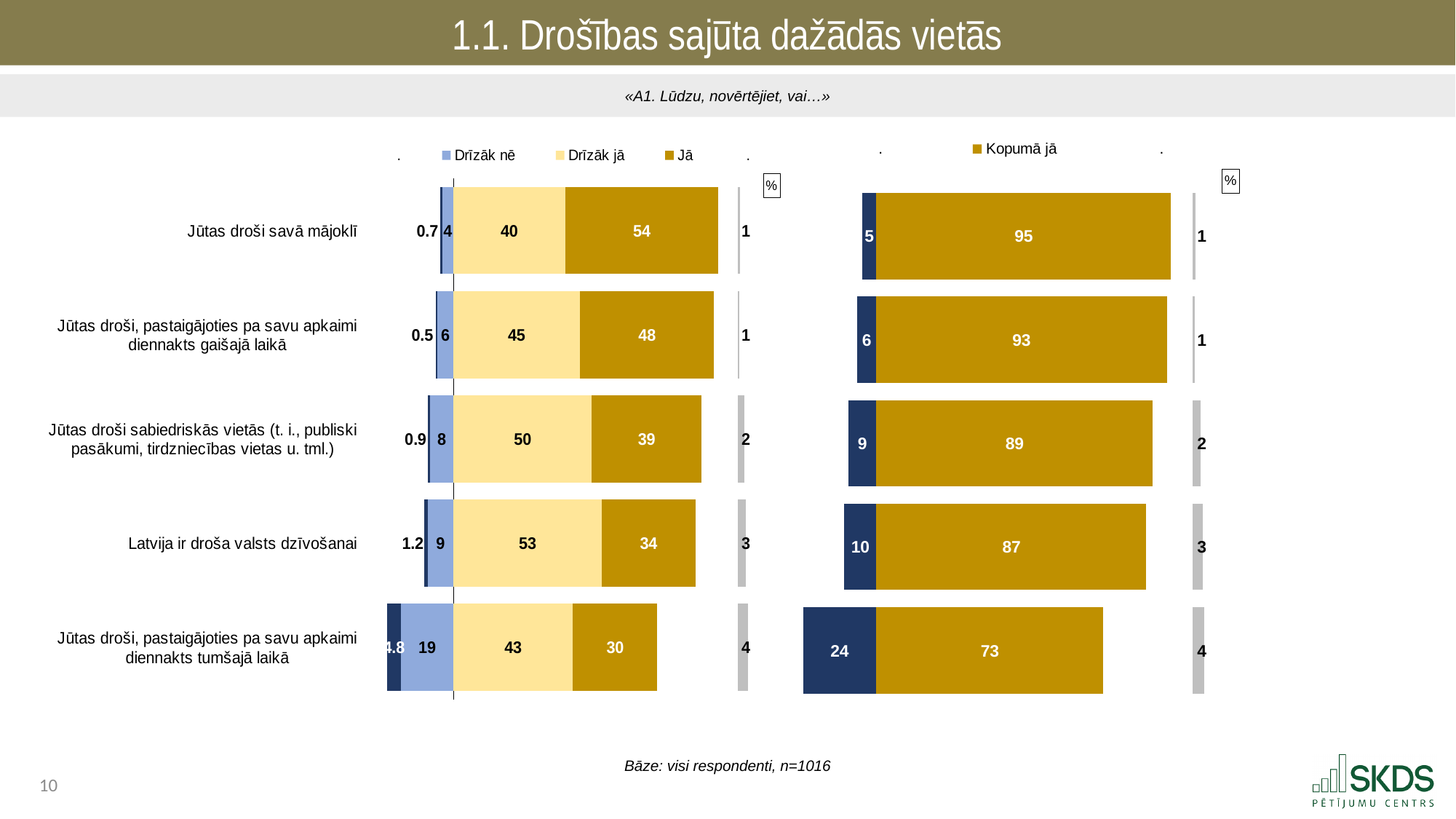
How many series does the legend of the left chart list? 3 In the right chart ('Kopumā jā'), what is the value for 'Latvija ir droša valsts dzīvošanai'? 87 In the right chart ('Kopumā jā'), which category has the lowest 'Kopumā jā' value? Jūtas droši, pastaigājoties pa savu apkaimi diennakts tumšajā laikā In the left chart, what is the 'Drīzāk jā' value for 'Jūtas droši sabiedriskās vietās (t. i., publiski pasākumi, tirdzniecības vietas u. tml.)'? 50 In the left chart, what is the 'Jā' value for 'Jūtas droši savā mājoklī'? 54 In the right chart ('Kopumā jā'), which category has the highest 'Kopumā jā' value? Jūtas droši savā mājoklī In the left chart, what is the 'Drīzāk nē' value for 'Jūtas droši, pastaigājoties pa savu apkaimi diennakts tumšajā laikā'? 19 In the right chart ('Kopumā jā'), what is the difference between the 'Kopumā jā' values for 'Jūtas droši savā mājoklī' and 'Jūtas droši, pastaigājoties pa savu apkaimi diennakts tumšajā laikā'? 22 In the left chart, which is larger: the 'Jā' value for 'Jūtas droši, pastaigājoties pa savu apkaimi diennakts gaišajā laikā' or the 'Jā' value for 'Latvija ir droša valsts dzīvošanai'? Jūtas droši, pastaigājoties pa savu apkaimi diennakts gaišajā laikā How many categories (statements) are shown in the left chart? 5 What kind of chart is the left chart? Stacked bar chart In the left chart, what is the combined 'Drīzāk jā' and 'Jā' value for 'Latvija ir droša valsts dzīvošanai'? 87